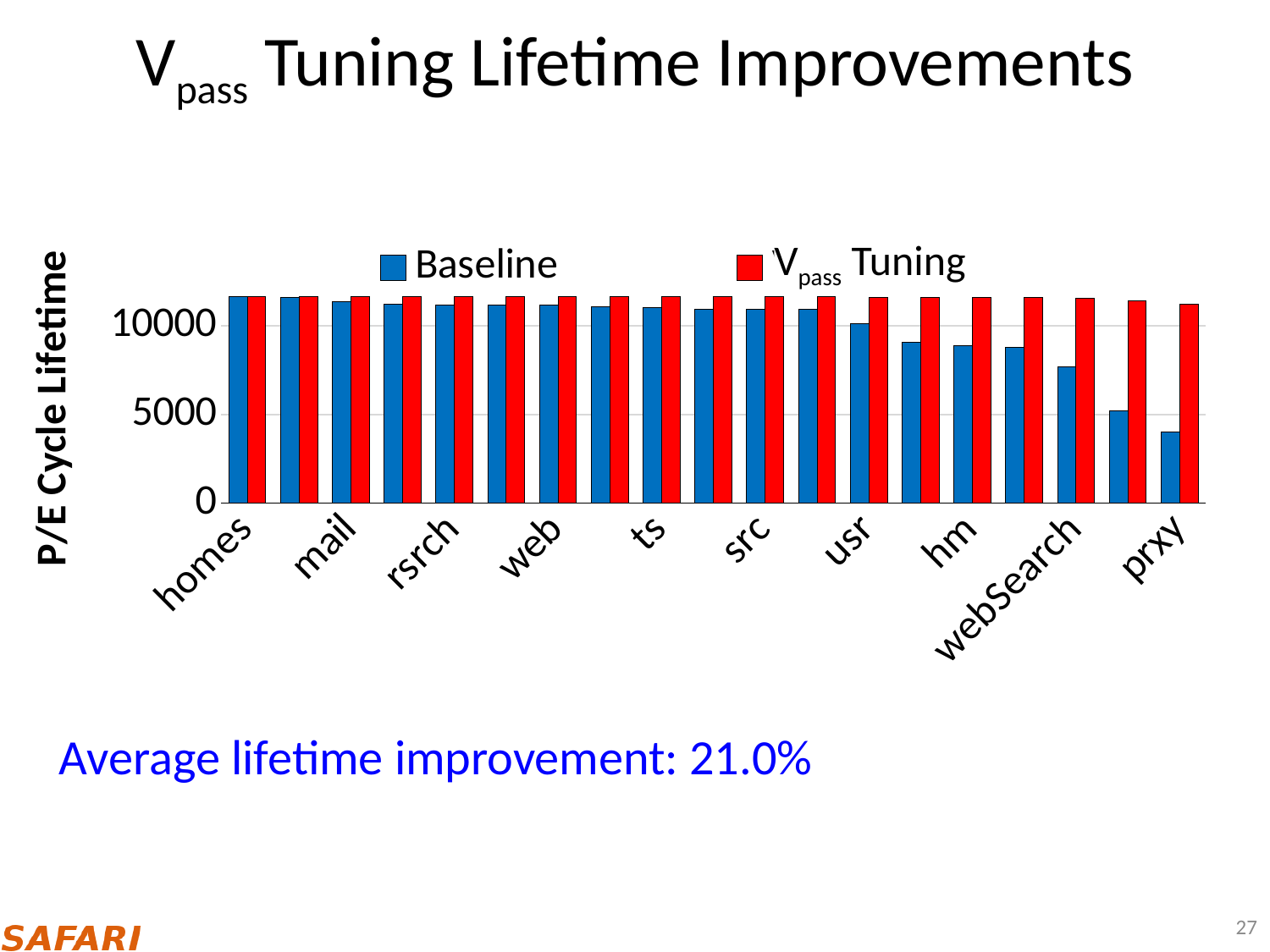
Is the Baseline value for homes greater or less than 10000? greater Is the Baseline value for hm greater or less than 10000? less What kind of chart is shown on the slide? bar chart For prxy, which is larger: the Baseline value or the Vpass Tuning value? Vpass Tuning How many series does the legend list? 2 Is the Baseline value for webSearch greater or less than 5000? greater Do the Baseline values rise or fall moving from homes to prxy along the x axis? fall What is the label of the y axis? P/E Cycle Lifetime What colour are the Baseline bars? blue Which category has the lowest Baseline value? prxy